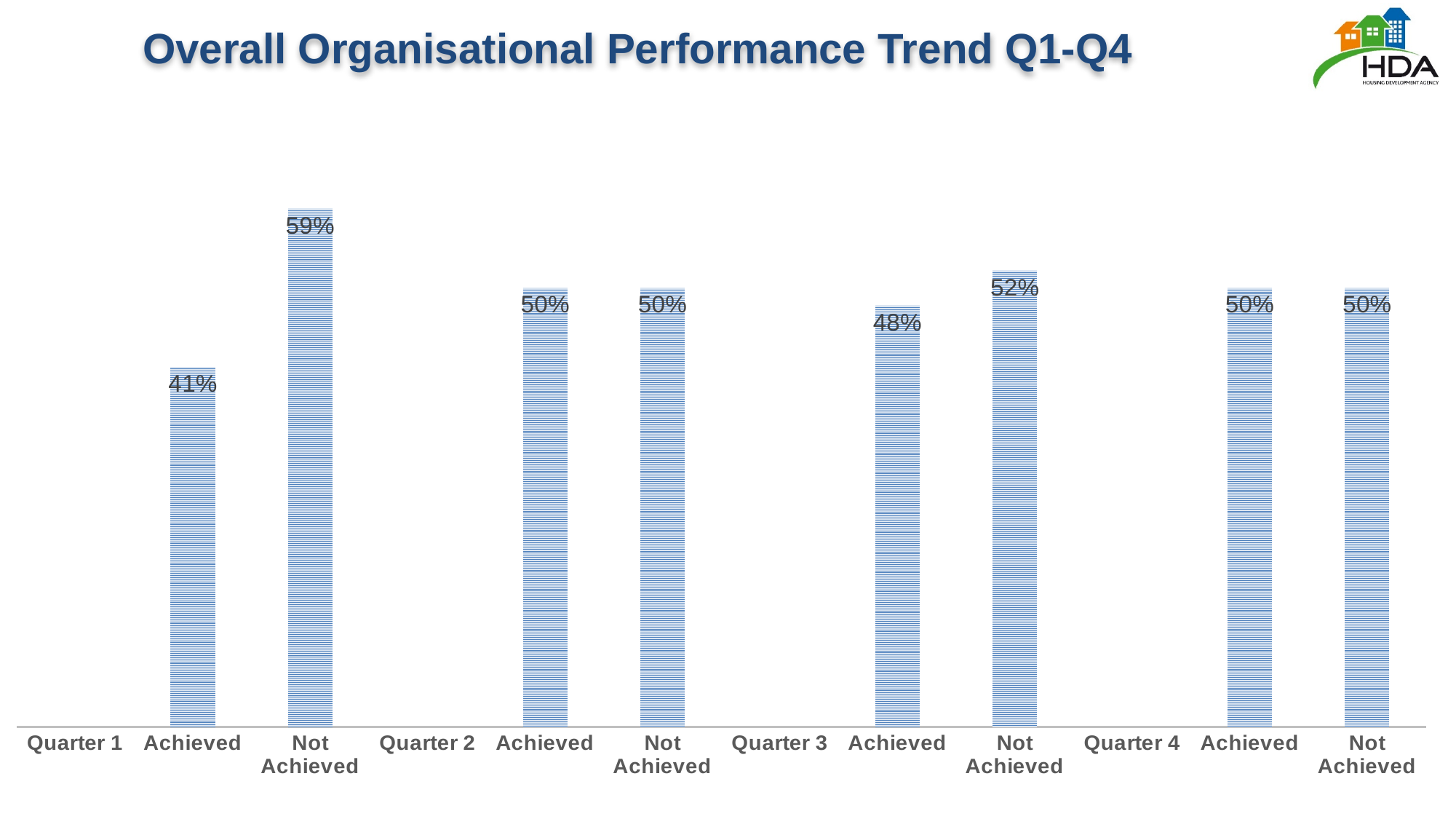
What is the value for Achieved in Quarter 3? 48% What is the difference between Not Achieved and Achieved in Quarter 3? 4% Which is larger in Quarter 3, Achieved or Not Achieved? Not Achieved Which bar has the lowest value on the chart? Achieved in Quarter 1 (41%) What is the value for Not Achieved in Quarter 1? 59% How many bars are plotted on the chart? 8 What type of chart is shown on the slide? Bar chart Which bar has the highest value on the chart? Not Achieved in Quarter 1 (59%) What is the value for Achieved in Quarter 1? 41% What is the value for Not Achieved in Quarter 3? 52% What is the value for Achieved in Quarter 4? 50% What is the difference between Not Achieved and Achieved in Quarter 1? 18%